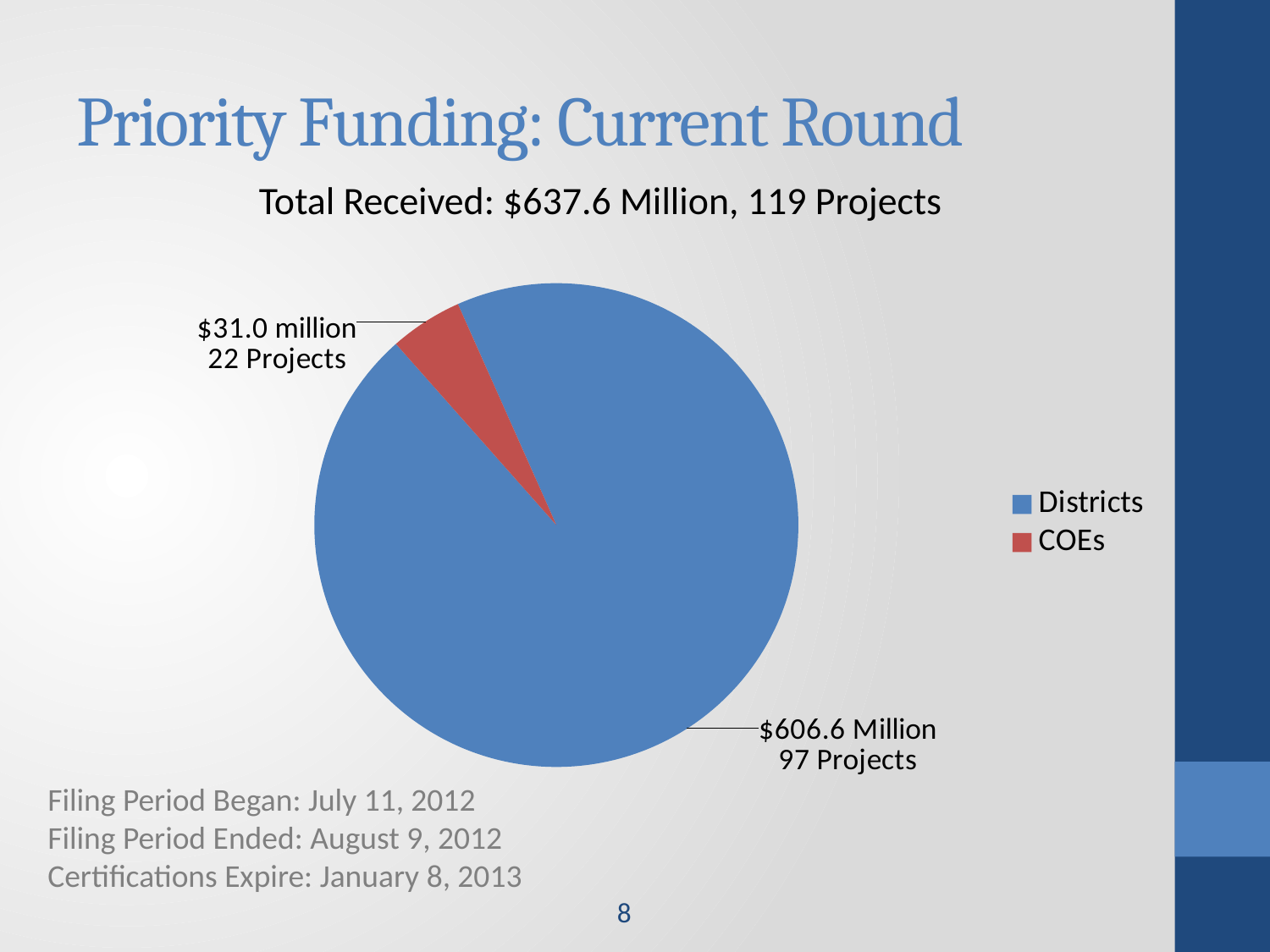
How many projects are attributed to COEs? 22 Projects How many entries does the legend list? 2 How many projects are attributed to Districts? 97 Projects How many more projects do Districts have than COEs? 75 How many slices does the pie chart have? 2 What is the funding amount for the COEs slice? $31.0 million What is the difference in funding between Districts and COEs? $575.6 million Which category received the smaller share of funding? COEs Which category received the larger share of funding? Districts What type of chart is shown on the slide? Pie chart What is the funding amount for the Districts slice? $606.6 Million What is the total funding received according to the chart subtitle? $637.6 Million